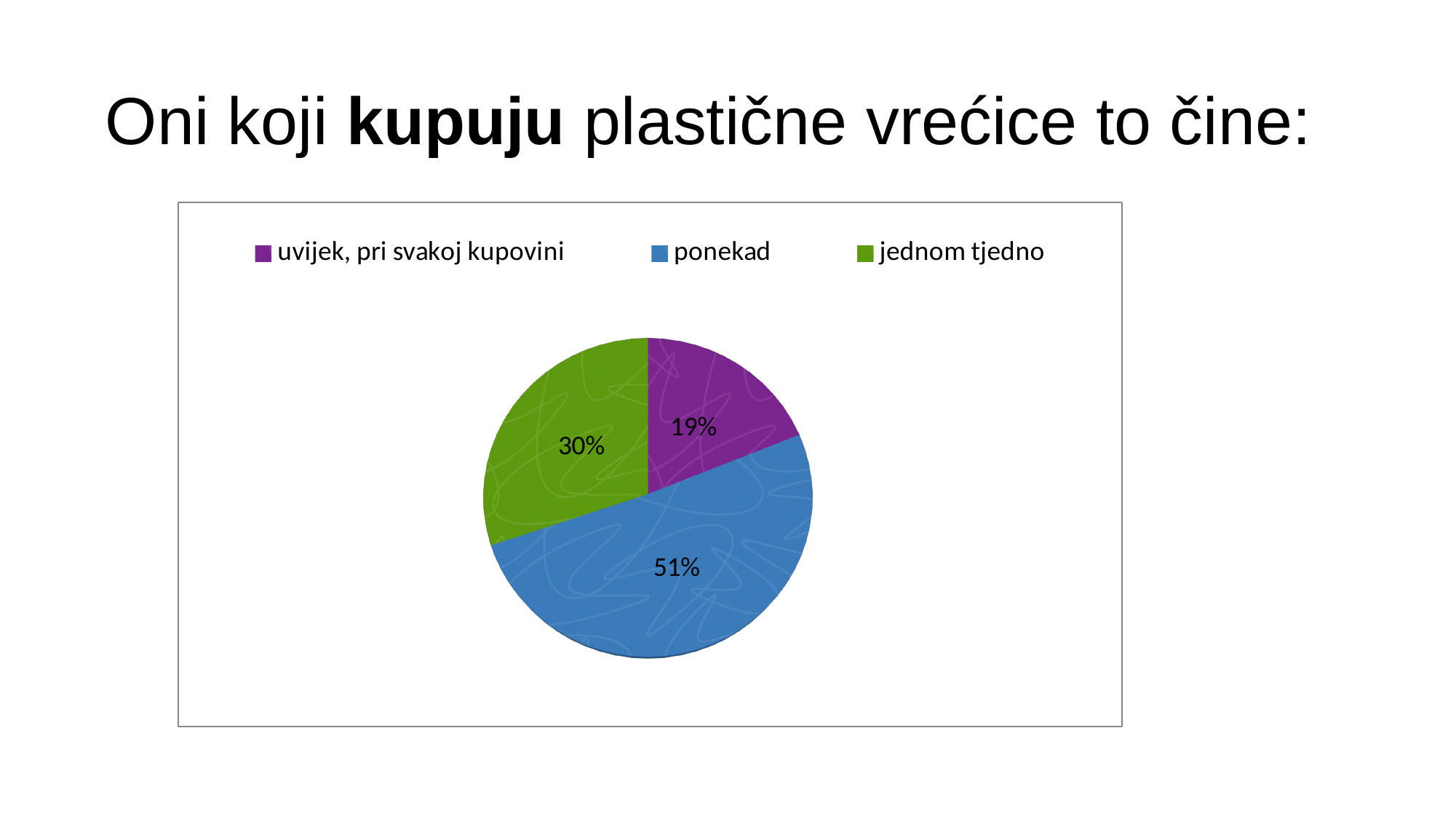
How many entries does the legend list? 3 What percentage of the pie is labelled "uvijek, pri svakoj kupovini"? 19% What is the difference in percentage points between "jednom tjedno" and "uvijek, pri svakoj kupovini"? 11 How many slices does the pie chart have? 3 What kind of chart is shown on the slide? pie chart Which is larger, the share for "jednom tjedno" or the share for "uvijek, pri svakoj kupovini"? jednom tjedno Which category has the largest share of the pie? ponekad What is the difference in percentage points between "ponekad" and "jednom tjedno"? 21 Which category has the smallest share of the pie? uvijek, pri svakoj kupovini What percentage of the pie is labelled "ponekad"? 51% What colour is the slice for "ponekad"? blue What percentage of the pie is labelled "jednom tjedno"? 30%